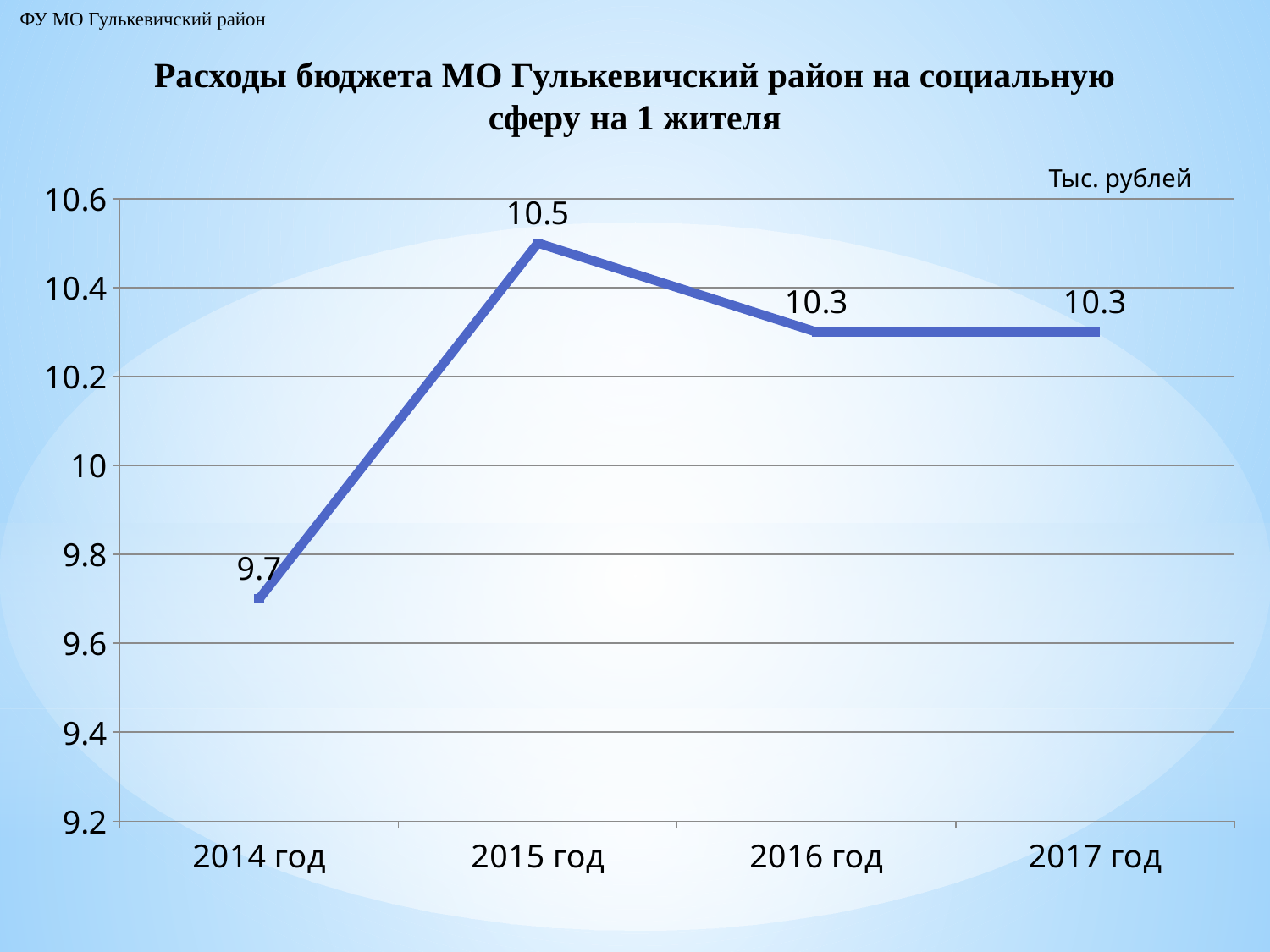
What is the difference between the values for 2015 год and 2014 год? 0.8 Is the value for 2014 год greater or less than 10? less Which is larger, the value for 2015 год or the value for 2016 год? 2015 год What is the value for 2014 год? 9.7 Which year has the highest value? 2015 год What unit is indicated for the values on the chart? Тыс. рублей What kind of chart is shown on the slide? line chart What is the value for 2016 год? 10.3 How many years are plotted on the chart? 4 What is the value for 2015 год? 10.5 Which year has the lowest value? 2014 год What is the value for 2017 год? 10.3